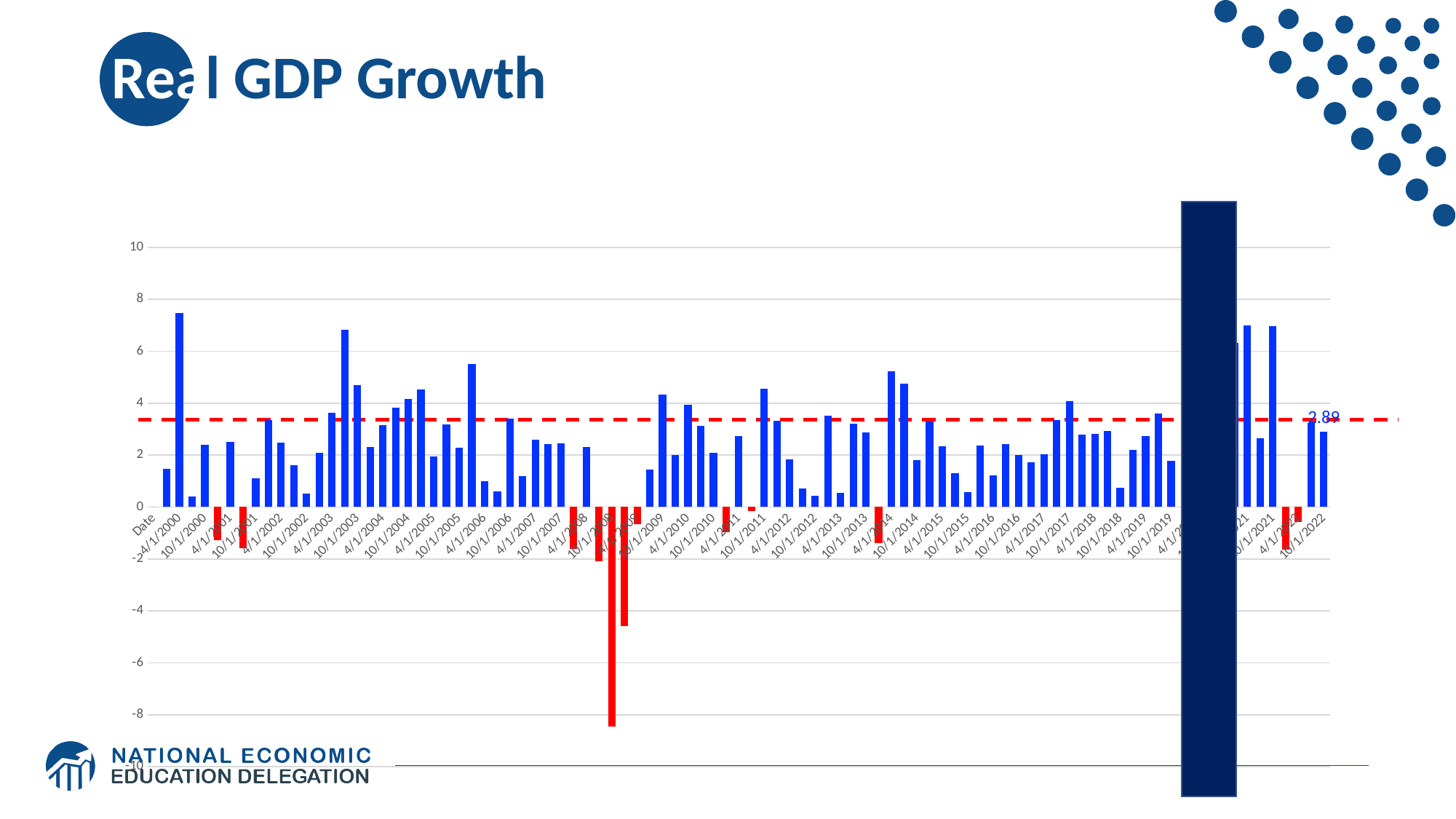
Is the red dashed line greater or less than 2? greater What is the highest value shown on the vertical axis? 10 Is the lowest (most negative) bar on the chart greater or less than -6? less What is the title of the chart on the slide? Real GDP Growth Is the last bar on the right of the chart greater or less than 2? greater What value is labelled on the red dashed horizontal line? 2.89 What kind of chart is shown on the slide? bar chart What colour are the bars with negative values? red